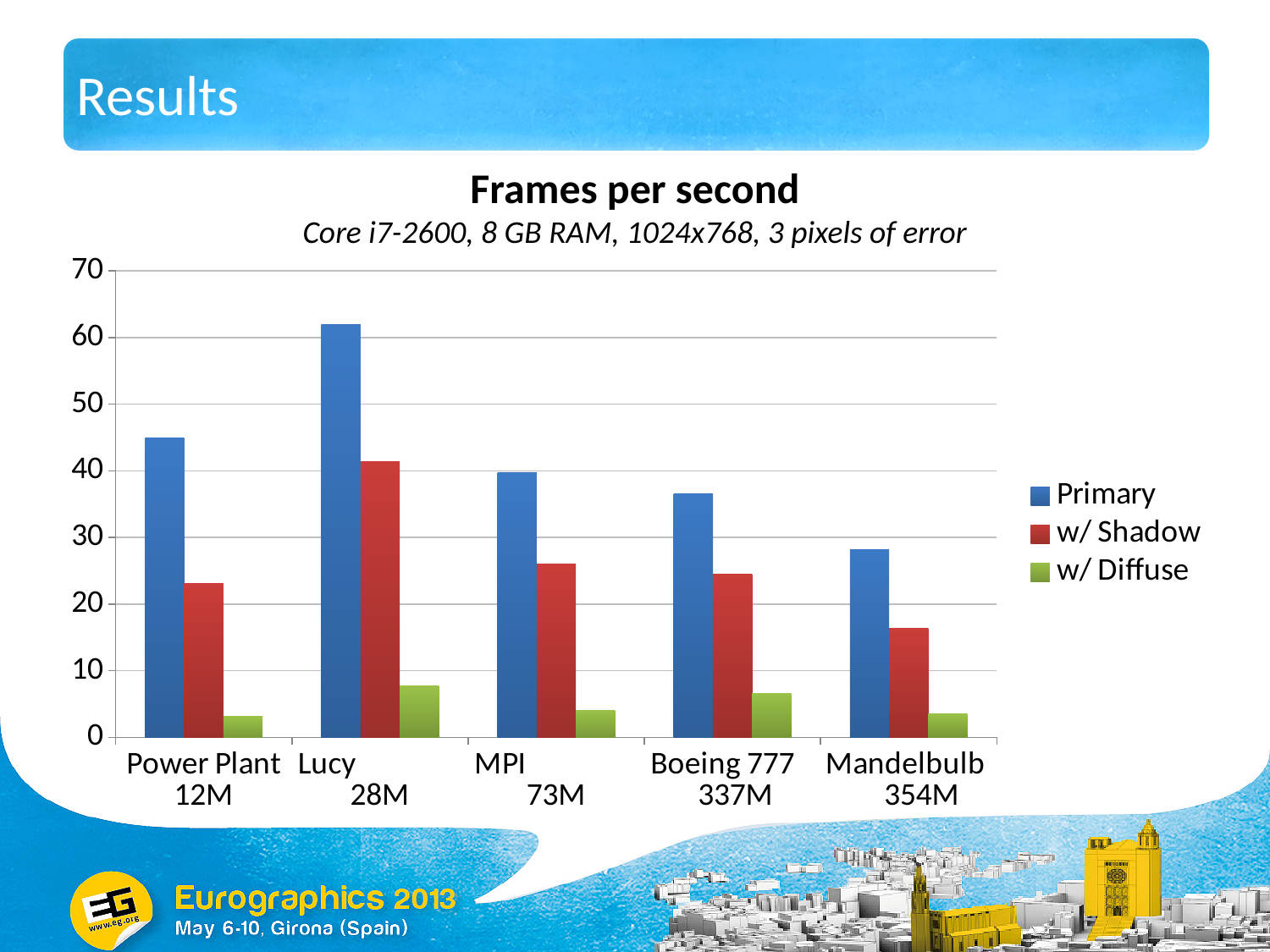
Is the Primary value for Lucy greater or less than 50? greater Which is larger, the Primary value for Power Plant or the Primary value for MPI? Power Plant What is the title of the chart? Frames per second Which scene has the lowest Primary frames per second? Mandelbulb Is the w/ Shadow value for Power Plant greater or less than 30? less Is the Primary value for Mandelbulb greater or less than 30? less Which scene has the highest Primary frames per second? Lucy What are the three legend entries of the chart? Primary, w/ Shadow, w/ Diffuse How many series does the legend list? 3 What kind of chart is shown on the slide? bar chart How many scenes (categories) are shown on the x axis? 5 Which scene has the lowest w/ Shadow frames per second? Mandelbulb